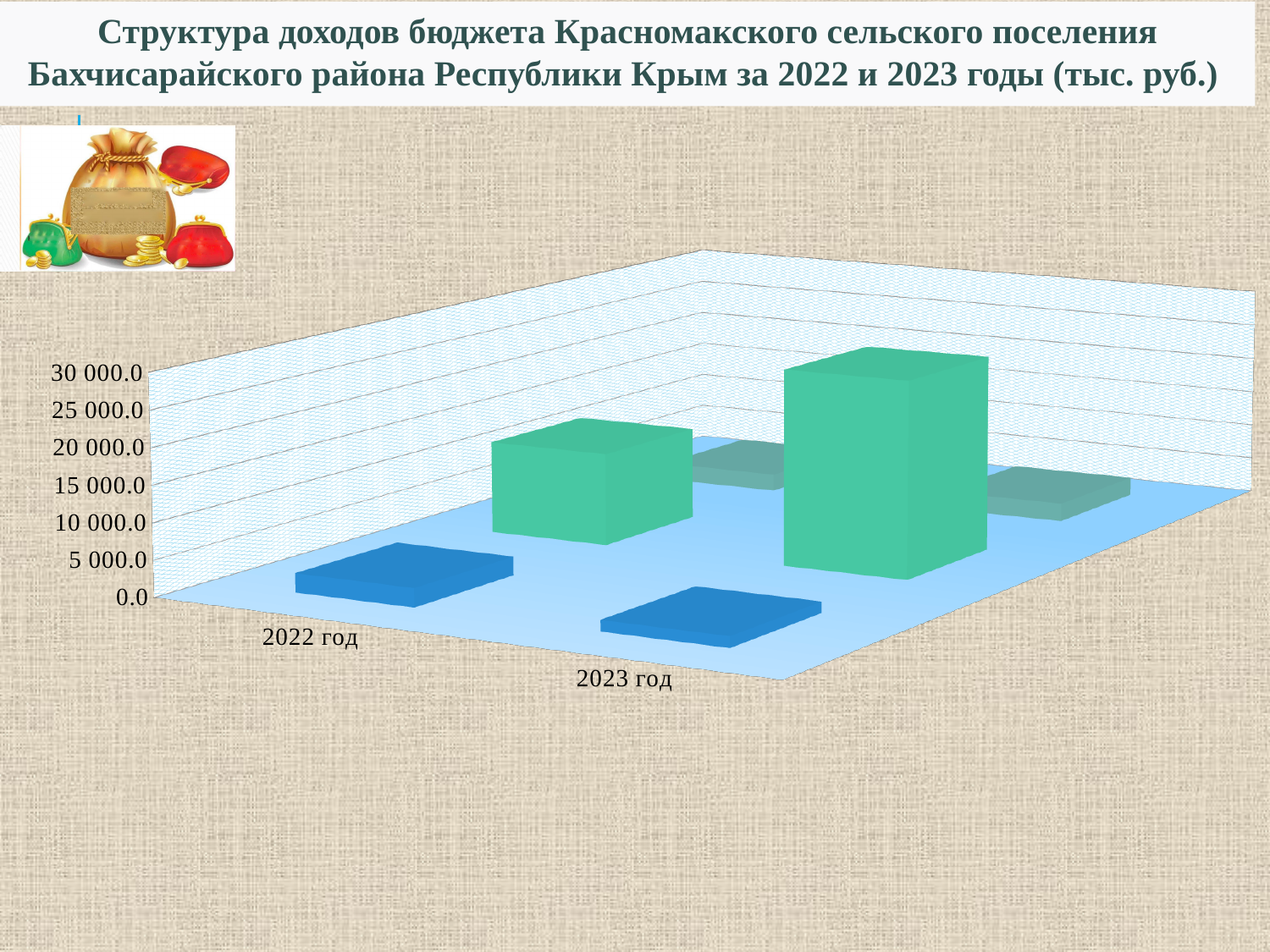
How many categories (years) are shown on the x axis of the chart? 2 What is the highest value shown on the vertical axis of the chart? 30 000.0 In what units are the values of the chart expressed, according to the slide title? тыс. руб. Is the value of the tall green bar for 2023 год greater or less than 15 000.0? greater What kind of chart is shown on the slide? bar chart Does the green series rise or fall from 2022 год to 2023 год? rise Which year has the taller green bar, 2022 год or 2023 год? 2023 год Is the value of the blue bar for 2022 год greater or less than 5 000.0? less Which two years are compared on the x axis of the chart? 2022 год and 2023 год Is the value of the blue bar for 2023 год greater or less than 5 000.0? less